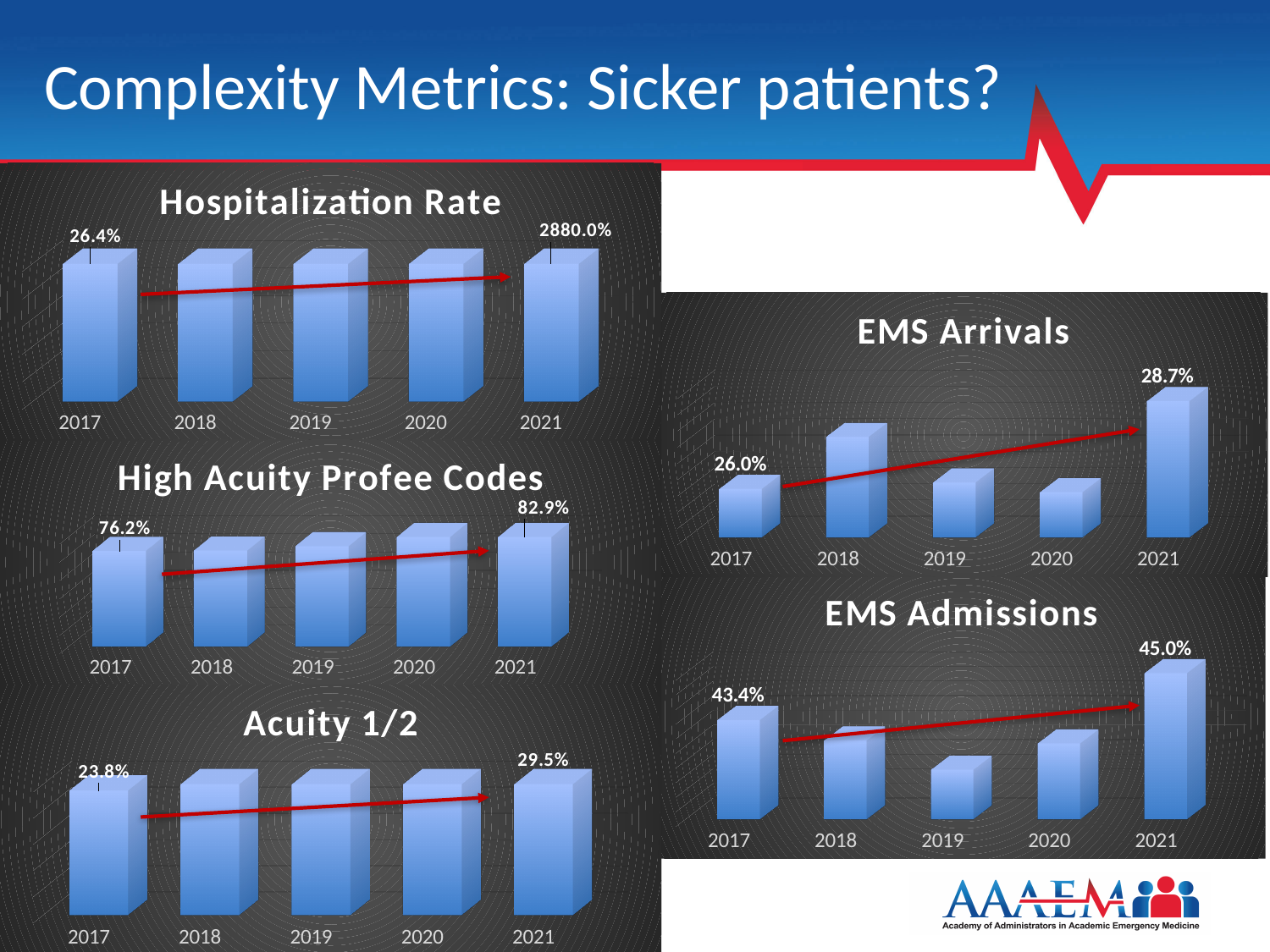
In the High Acuity Profee Codes chart, what is the value for 2021? 82.9% In the EMS Admissions chart, what is the value for 2017? 43.4% In the High Acuity Profee Codes chart, what is the difference between the 2021 and 2017 values? 6.7% In the EMS Arrivals chart, what is the value for 2021? 28.7% In the EMS Admissions chart, which year has the lowest value? 2019 In the Hospitalization Rate chart, what is the value for 2017? 26.4% In the EMS Arrivals chart, which year has the highest value? 2021 In the Hospitalization Rate chart, what value is labeled on the 2021 bar? 2880.0% In the Acuity 1/2 chart, what is the value for 2017? 23.8% How many years are shown on the x axis of the EMS Admissions chart? 5 What type of chart is the EMS Arrivals chart? Bar chart In the Acuity 1/2 chart, which is larger, the value for 2017 or the value for 2021? 2021